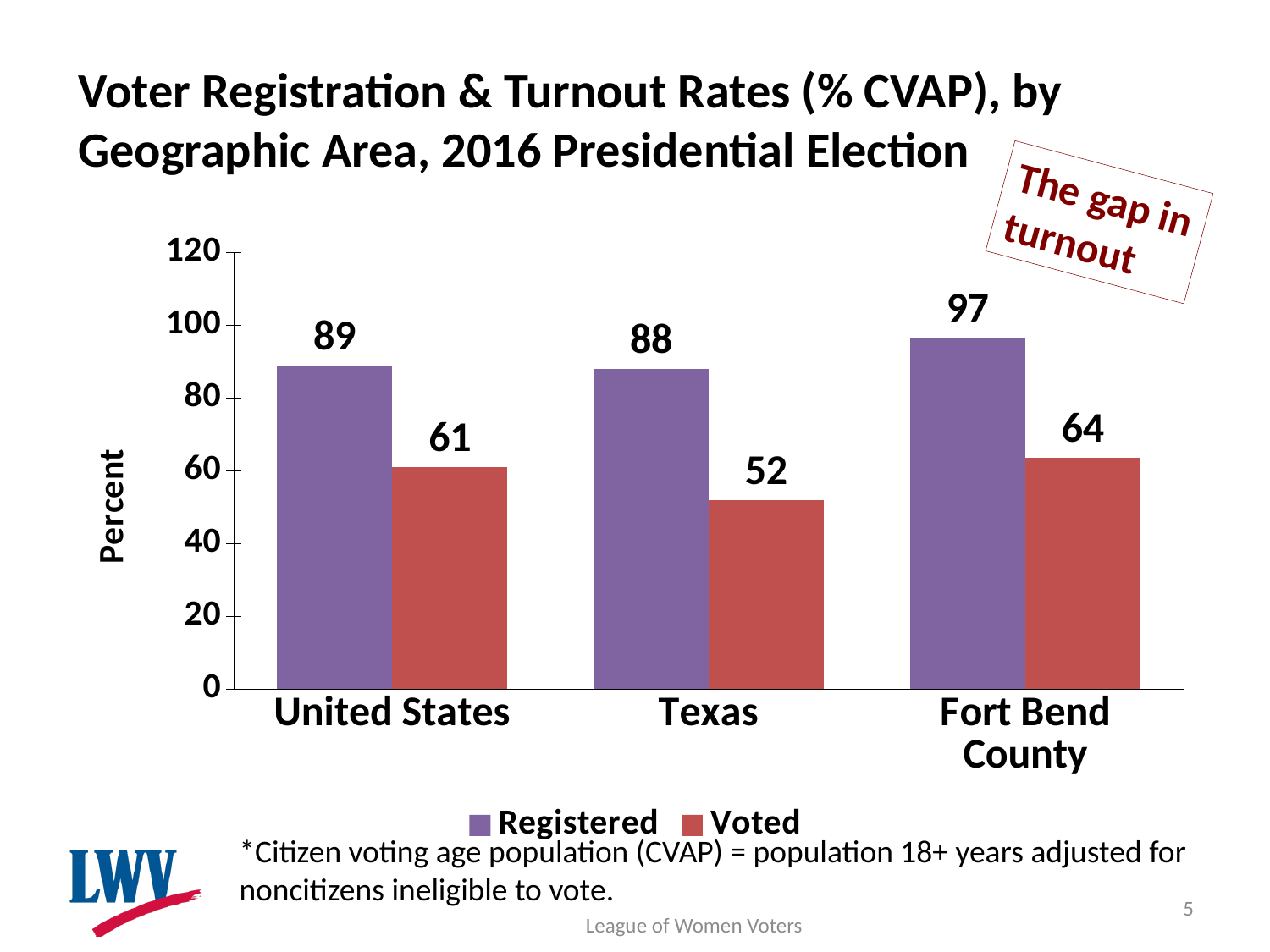
Which geographic area has the highest Registered value? Fort Bend County What is the Voted value for Fort Bend County? 64 How many geographic areas are shown on the x axis? 3 What is the Registered value for Texas? 88 Which geographic area has the lowest Voted value? Texas What is the Voted value for the United States? 61 What is the difference between the Registered and Voted values for Texas? 36 What is the difference between the Registered values for Fort Bend County and the United States? 8 Is the Voted value for Texas greater or less than 60? less How many series does the legend list? 2 What kind of chart is shown on the slide? bar chart Which is larger, the Voted value for the United States or the Voted value for Fort Bend County? Fort Bend County